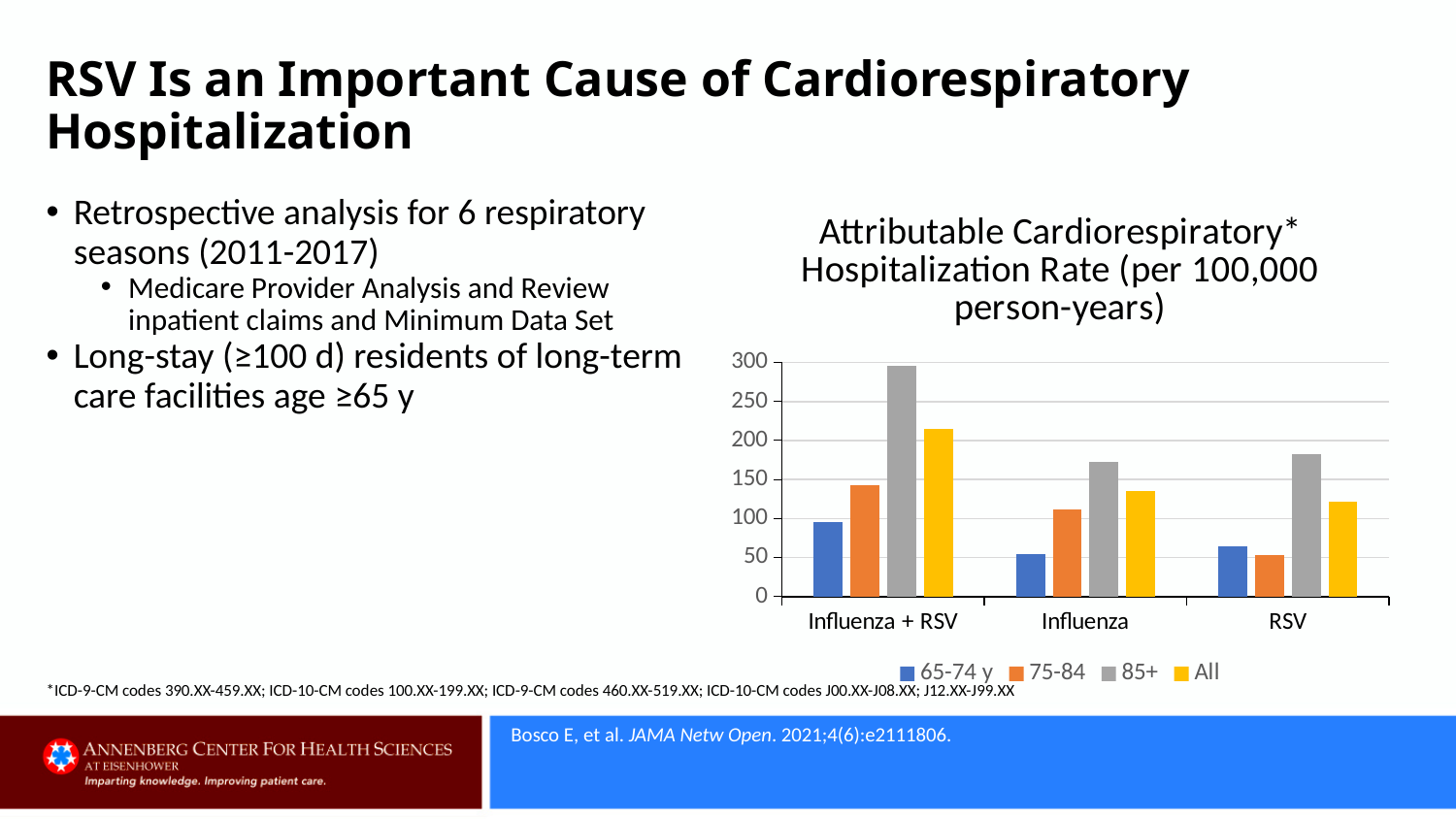
Is the value for the All group in the RSV category greater or less than 100? greater How many series does the chart's legend list? 4 Is the value for the 85+ group in the RSV category greater or less than 150? greater How many categories are shown on the x axis of the chart? 3 Is the value for the 85+ group in the Influenza + RSV category greater or less than 250? greater Which age group has the highest attributable hospitalization rate in the Influenza + RSV category? 85+ Which is larger: the 65-74 y value for Influenza + RSV or the 65-74 y value for Influenza? Influenza + RSV Which is larger: the 75-84 value for Influenza or the 75-84 value for RSV? Influenza Which age group has the lowest attributable hospitalization rate in the Influenza category? 65-74 y What kind of chart is shown on the slide? bar chart What unit is the hospitalization rate in the chart title expressed in? per 100,000 person-years